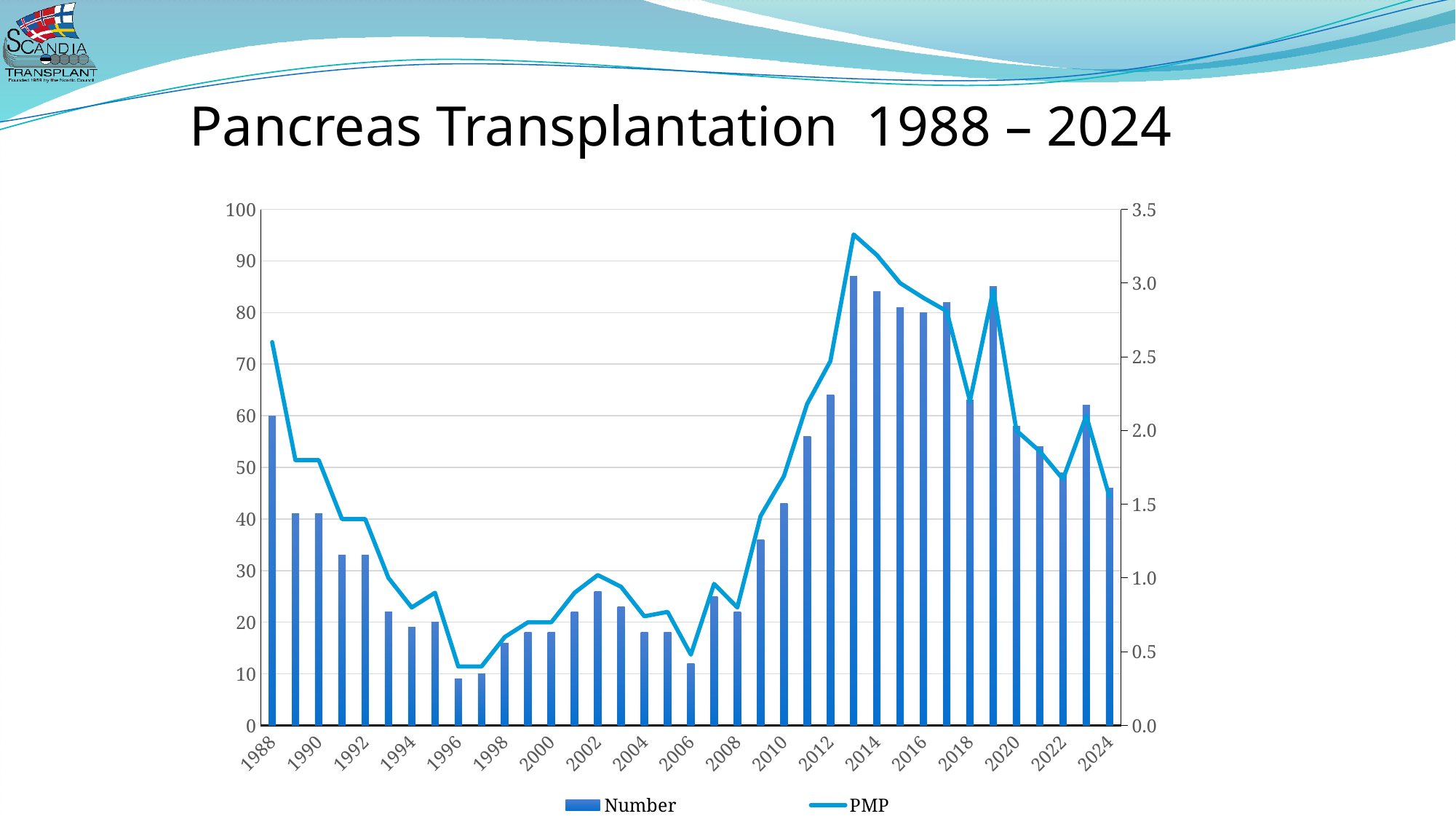
What kind of chart is shown on the slide? bar and line chart Is the PMP value for 1996 greater or less than 0.5? less What are the two series named in the legend? Number and PMP In which year does the PMP line reach its highest value? 2013 Which year has the larger Number value, 1988 or 2024? 1988 What is the Number value for 1988? 60 How many series does the legend list? 2 Do the Number bars rise or fall from 1988 to 1996? fall Is the PMP value for 2013 greater or less than 3.0? greater Is the Number value for 2013 greater or less than 80? greater What is the Number value for 2016? 80